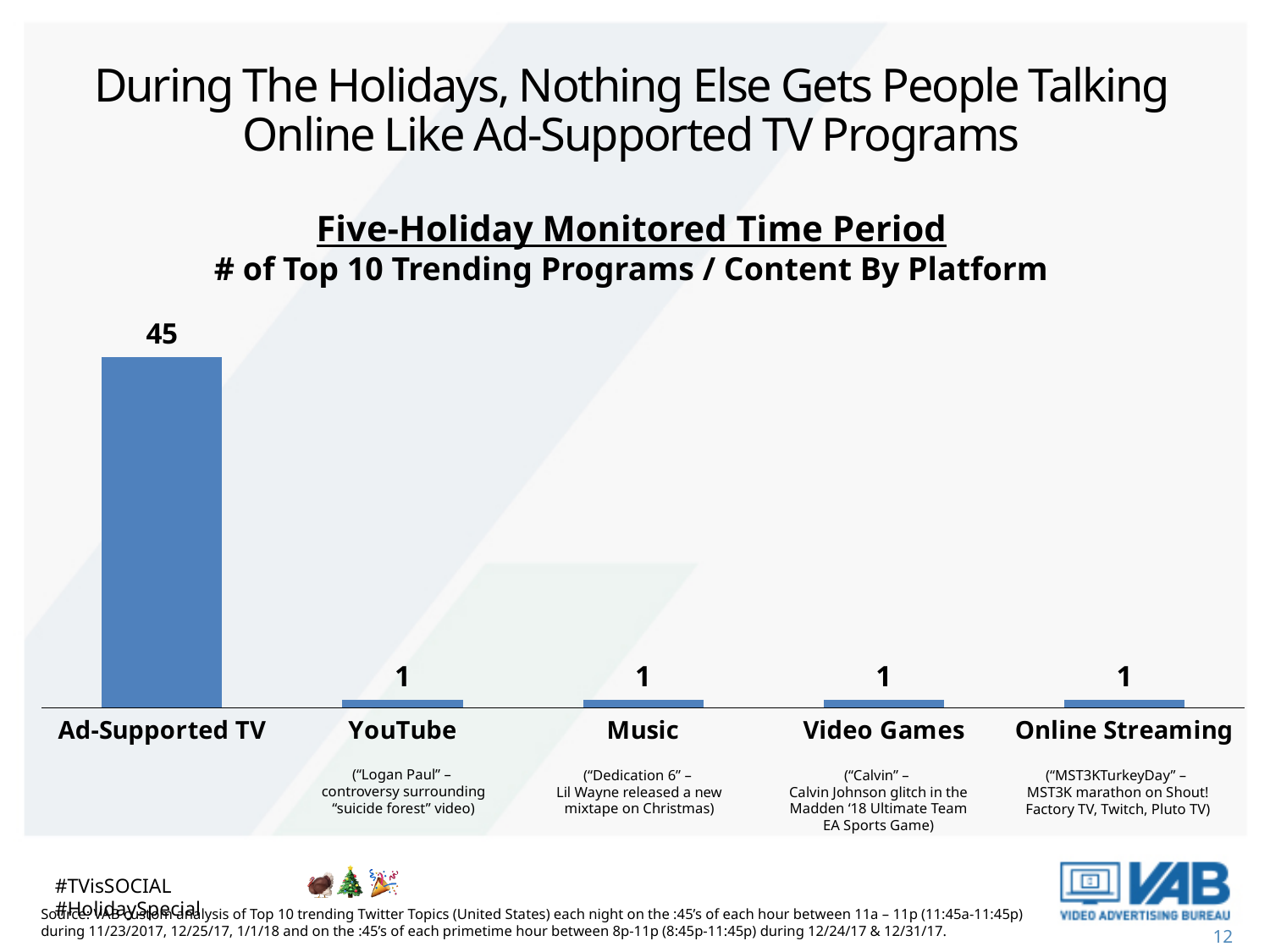
Which is larger, the value for Ad-Supported TV or the value for Video Games? Ad-Supported TV Which category has the highest value? Ad-Supported TV What is the value for Ad-Supported TV? 45 What is the value for YouTube? 1 What is the chart's subtitle describing what is plotted? # of Top 10 Trending Programs / Content By Platform How many categories have a value of 1? 4 What is the difference between the values for Ad-Supported TV and Music? 44 What is the total of all the values shown in the chart? 49 What is the value for Online Streaming? 1 How many categories are shown in the chart? 5 What kind of chart is shown on the slide? Bar chart What is the value for Video Games? 1